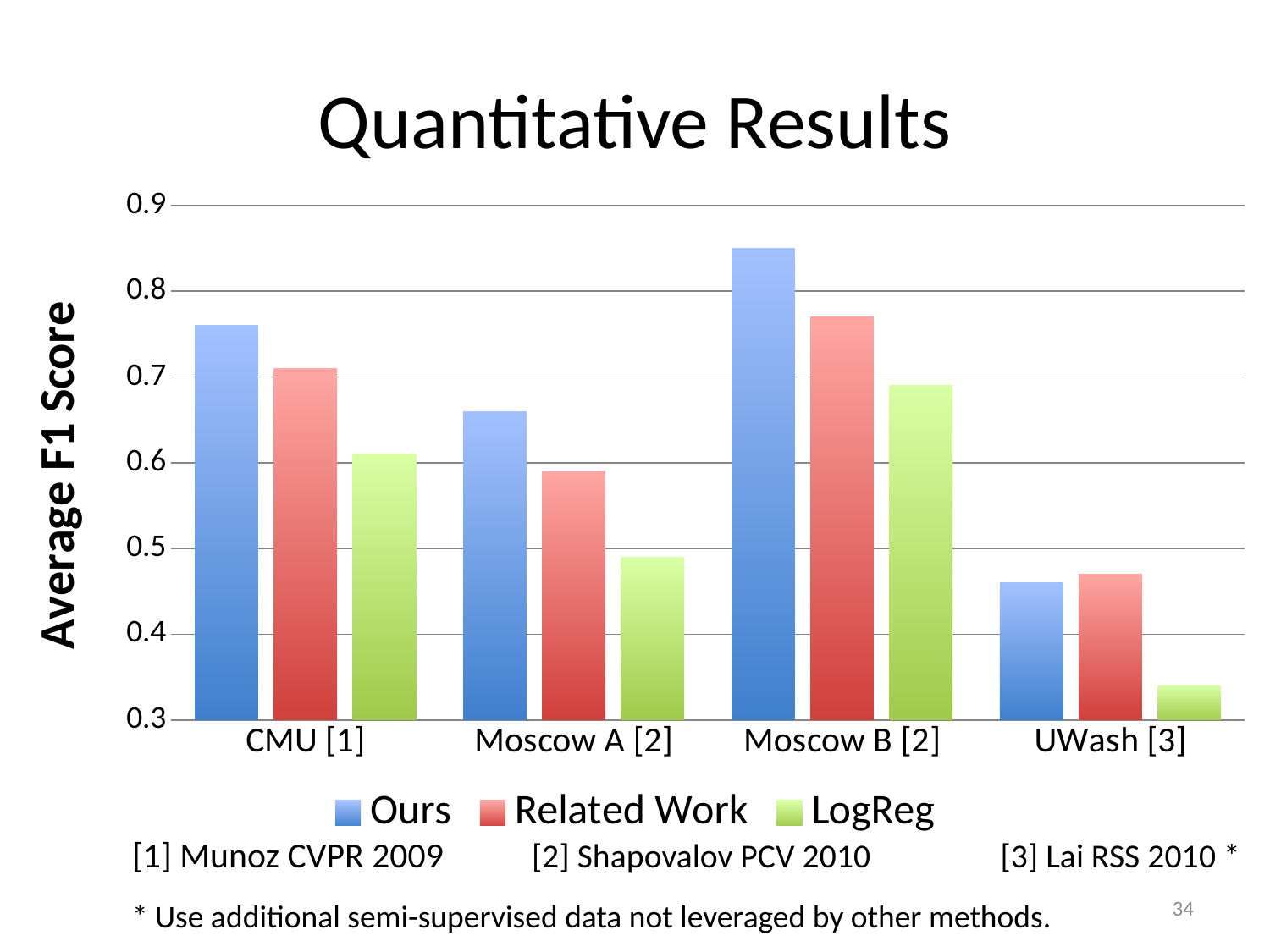
For which dataset is the LogReg series lowest? UWash [3] Is the Ours value for Moscow A [2] greater or less than 0.6? greater How many series does the legend list? 3 Is the LogReg value for UWash [3] greater or less than 0.4? less What is the label of the y axis? Average F1 Score What type of chart is shown on the slide? bar chart For which dataset is the Ours series highest? Moscow B [2] Is the Ours value for Moscow B [2] greater or less than 0.8? greater For CMU [1], which is larger: Ours or Related Work? Ours How many dataset categories are shown on the x axis? 4 For Moscow B [2], which is larger: Related Work or LogReg? Related Work